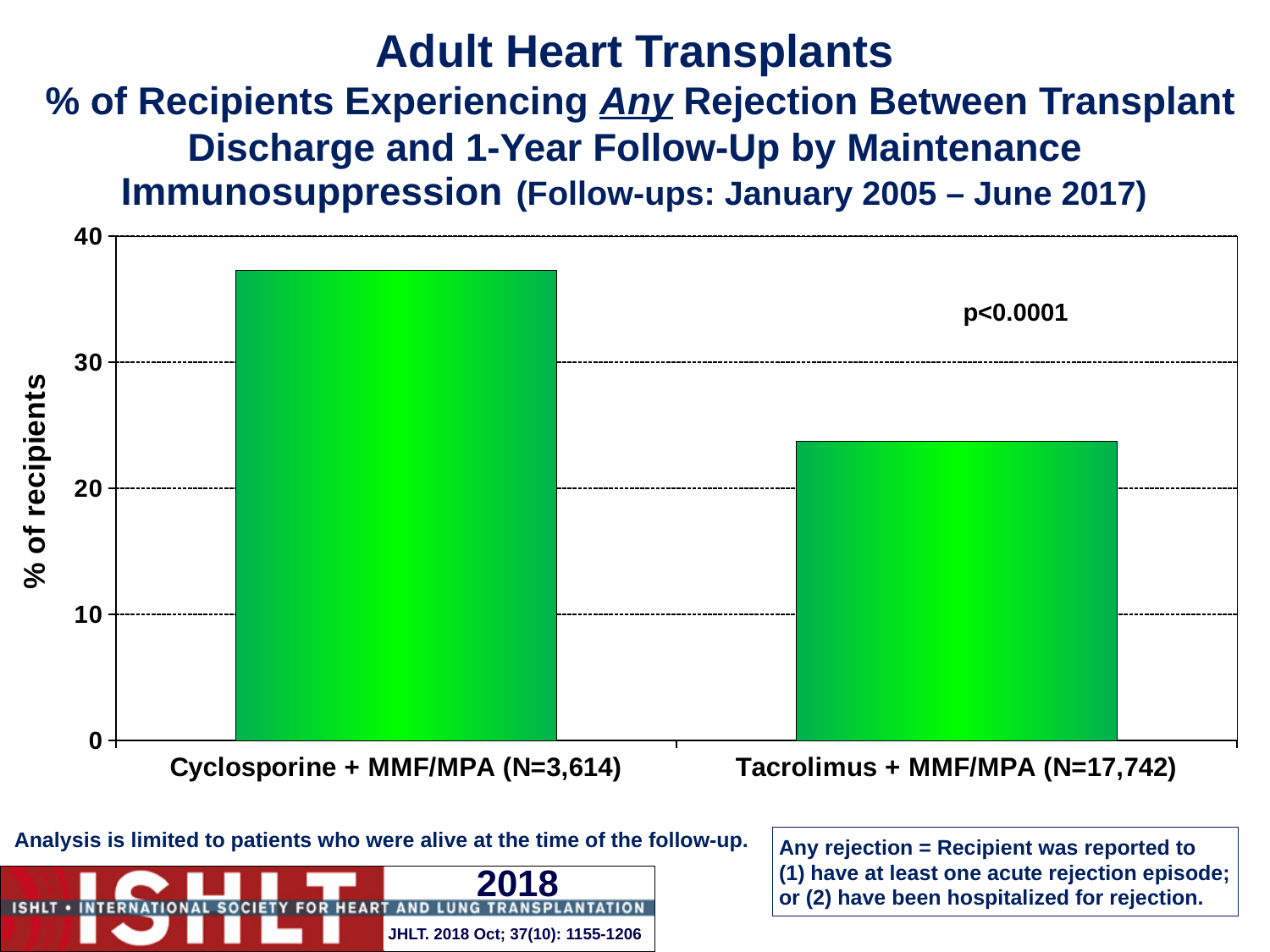
Which category has the lowest % of recipients experiencing any rejection? Tacrolimus + MMF/MPA (N=17,742) Is the value for Tacrolimus + MMF/MPA greater or less than 20? greater Is the value for Tacrolimus + MMF/MPA greater or less than 30? less Is the value for Cyclosporine + MMF/MPA greater or less than 30? greater How many categories (bars) are plotted in the chart? 2 Which category has the highest % of recipients experiencing any rejection? Cyclosporine + MMF/MPA (N=3,614) What p-value is shown on the chart? p<0.0001 What kind of chart is shown on the slide? bar chart What is the label on the y axis of the chart? % of recipients What is the maximum value shown on the y axis? 40 Which is larger: the value for Cyclosporine + MMF/MPA or the value for Tacrolimus + MMF/MPA? Cyclosporine + MMF/MPA